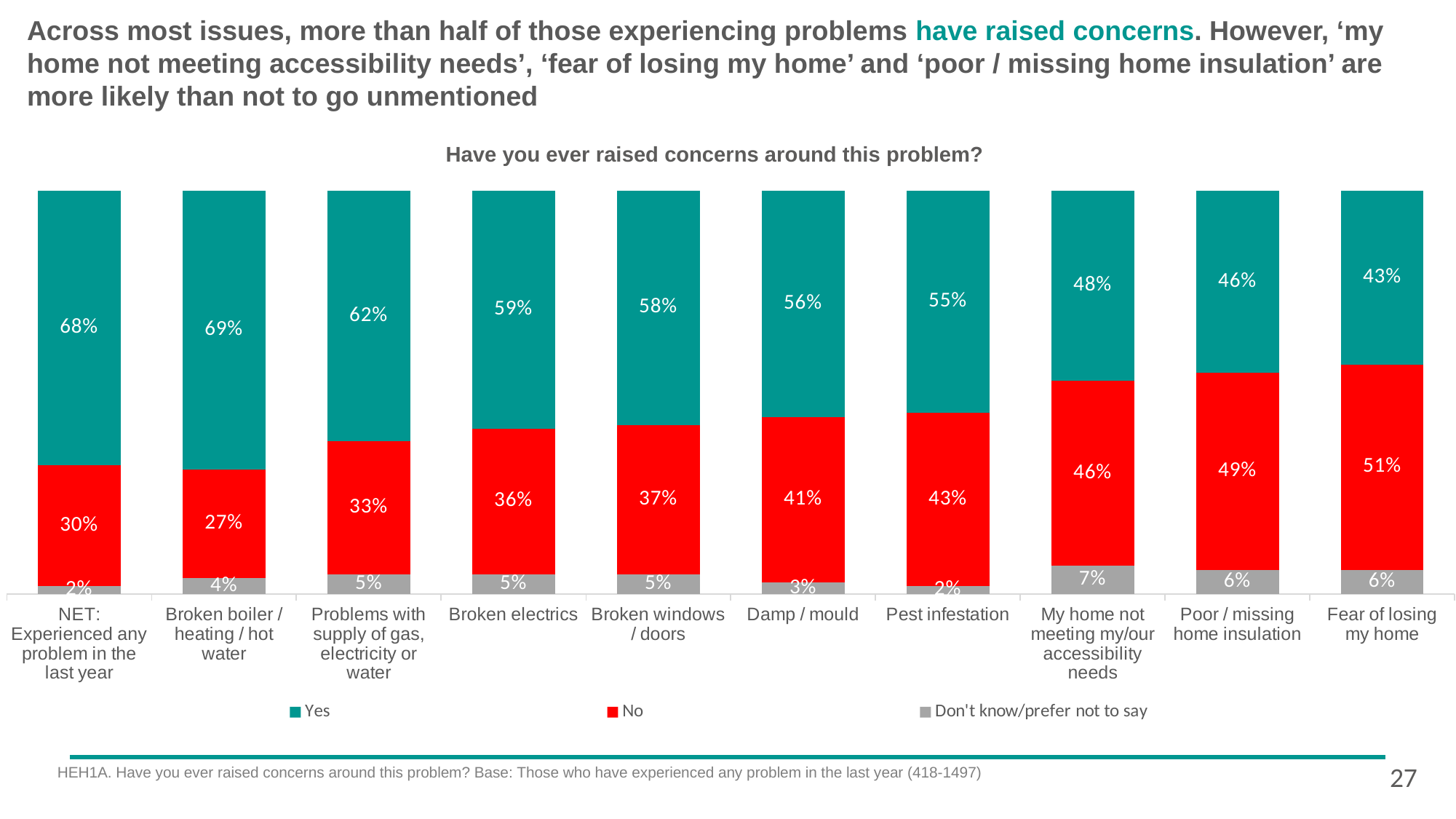
What kind of chart is this? Stacked bar chart What is the 'Don't know/prefer not to say' value for My home not meeting my/our accessibility needs? 7% What is the 'No' value for Fear of losing my home? 51% What is the title of the chart? Have you ever raised concerns around this problem? Which is larger: the 'No' value for Poor / missing home insulation or the 'No' value for Damp / mould? Poor / missing home insulation How many categories are shown on the x axis? 10 What is the 'Yes' value for Broken electrics? 59% Do the 'Yes' values generally rise or fall from left to right across the categories? Fall How many series does the legend list? 3 What is the difference between the 'Yes' values for Damp / mould and Pest infestation? 1% Which category has the highest 'Yes' value? Broken boiler / heating / hot water Which category has the lowest 'Yes' value? Fear of losing my home